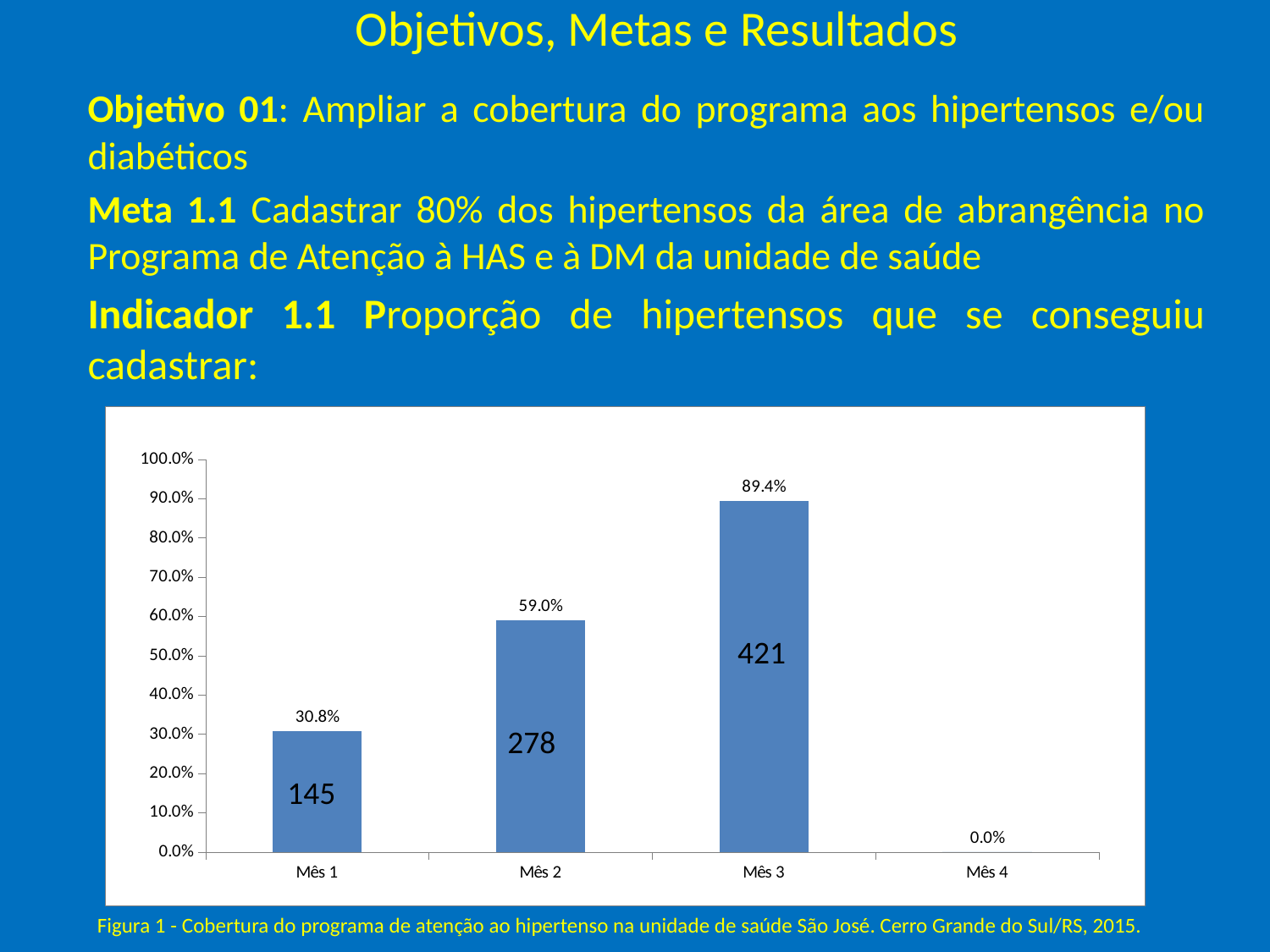
What is the difference between the values for Mês 3 and Mês 2? 30.4% How many months are shown on the x axis? 4 Which month has the highest value? Mês 3 Do the values rise or fall from Mês 1 to Mês 3? Rise What number is printed inside the bar for Mês 3? 421 What is the value for Mês 2? 59.0% Which month has the lowest value? Mês 4 What is the value for Mês 4? 0.0% What is the value for Mês 3? 89.4% Which is larger, the value for Mês 1 or the value for Mês 2? Mês 2 What is the value for Mês 1? 30.8% What kind of chart is shown on the slide? Bar chart